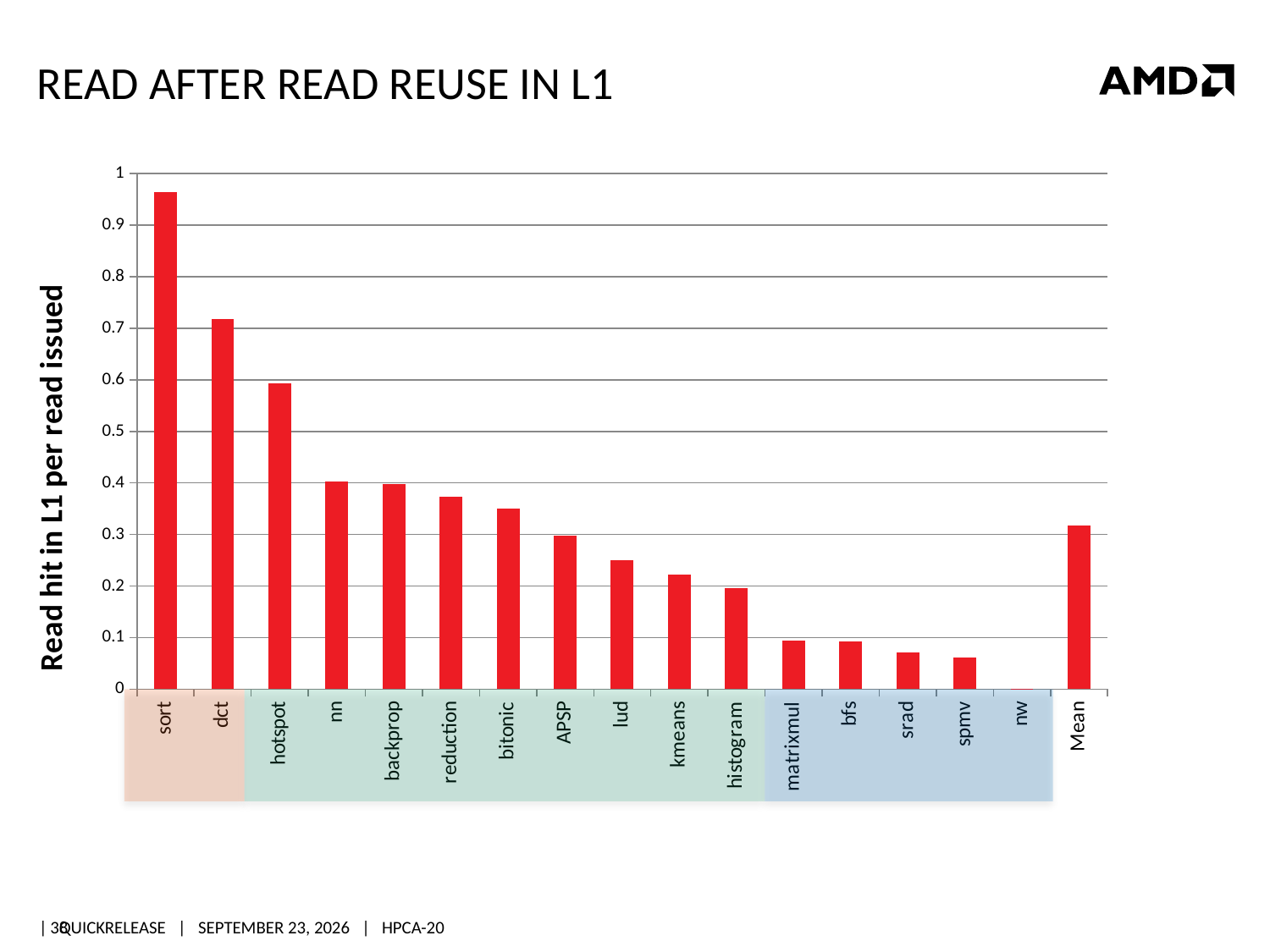
Which category has the highest read hit in L1 per read issued? sort Is the value for dct greater or less than 0.7? greater How many categories are plotted on the x axis, including Mean? 17 Is the value for reduction greater or less than 0.4? less Is the value for Mean greater or less than 0.3? greater Which category has the lowest read hit in L1 per read issued? nw Do the values rise or fall along the x axis from sort to nw? fall Which has a larger value, hotspot or nn? hotspot What kind of chart is shown on the slide? bar chart What is the label on the vertical axis? Read hit in L1 per read issued